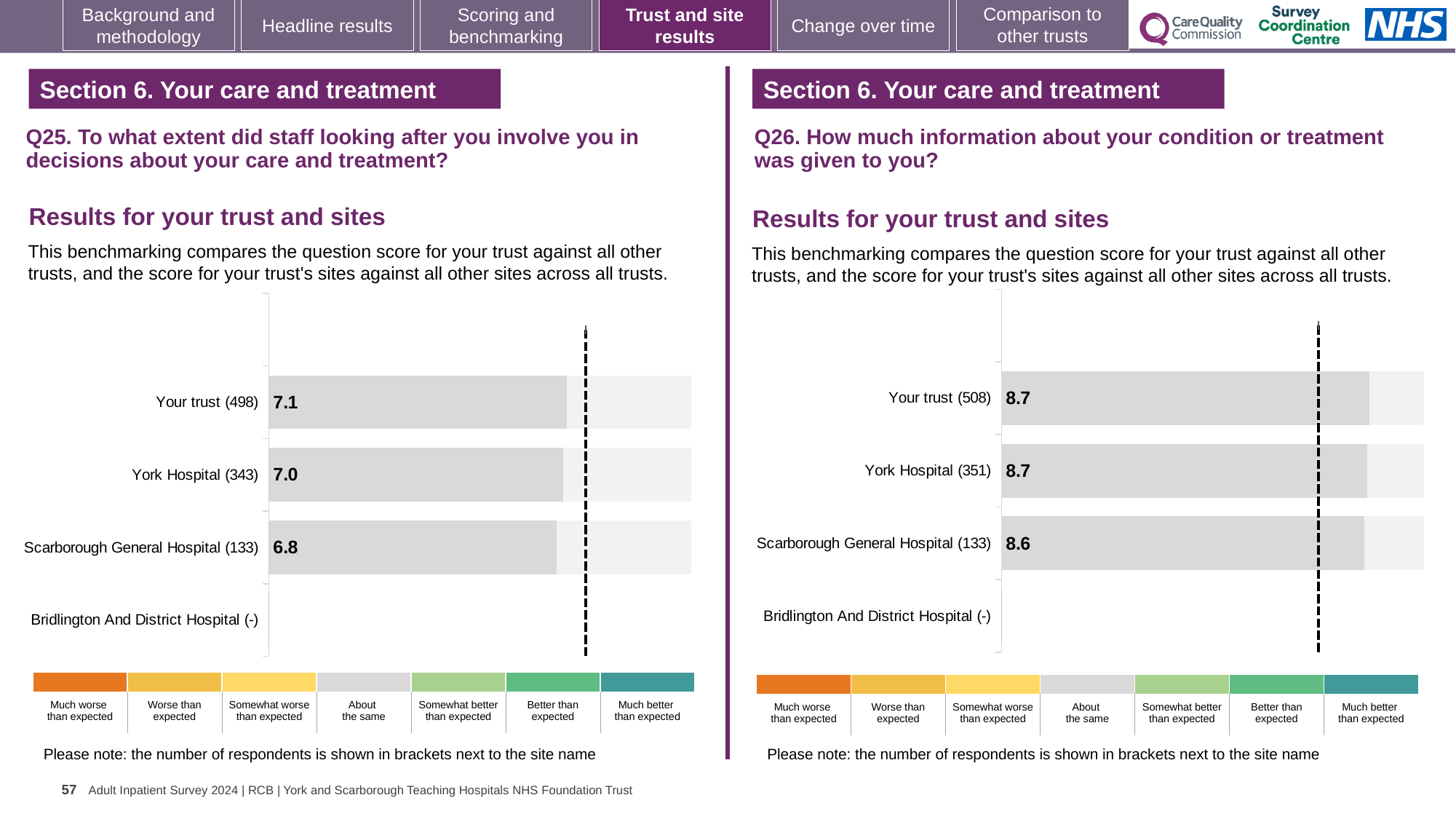
In the Q25 chart on the left, what is the difference between the scores for Your trust and Scarborough General Hospital? 0.3 How many sites or trusts are listed on the y axis of the Q25 chart on the left? 4 In the Q26 chart on the right, what is the score for Scarborough General Hospital? 8.6 What kind of chart is used for the Q26 results on the right? Bar chart In the Q25 chart on the left, what is the score for Scarborough General Hospital? 6.8 In the Q26 chart on the right, what is the difference between the scores for Your trust and Scarborough General Hospital? 0.1 How many respondents are shown in brackets for Your trust in the Q26 chart on the right? 508 In the Q25 chart on the left, what is the score for Your trust? 7.1 In the Q25 chart on the left, which site or trust has the lowest score shown? Scarborough General Hospital In the Q25 chart on the left, which site has no score shown (marked with a dash)? Bridlington And District Hospital In the Q26 chart on the right, what is the score for York Hospital? 8.7 In the Q25 chart on the left, which has the higher score, York Hospital or Scarborough General Hospital? York Hospital